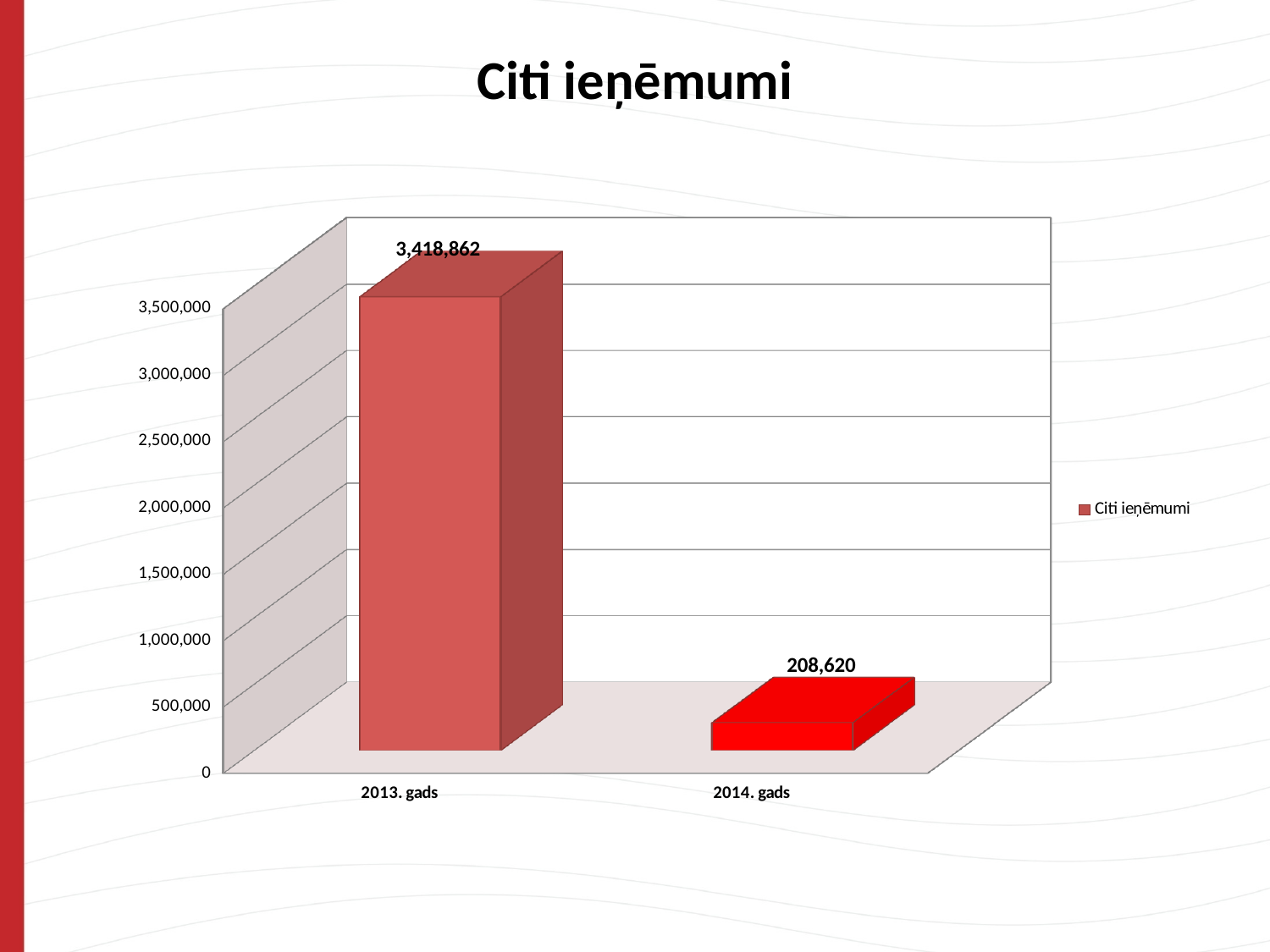
Is the value for 2013. gads greater or less than 3,000,000? greater What is the value for 2013. gads? 3,418,862 What is the title of the chart? Citi ieņēmumi How many series does the legend list? 1 Which year has the lowest value? 2014. gads What is the difference between the values for 2013. gads and 2014. gads? 3,210,242 Which year has the highest value? 2013. gads Is the value for 2014. gads greater or less than 500,000? less How many categories are shown on the x axis? 2 What kind of chart is shown on the slide? bar chart Which is larger, the value for 2013. gads or for 2014. gads? 2013. gads What is the value for 2014. gads? 208,620